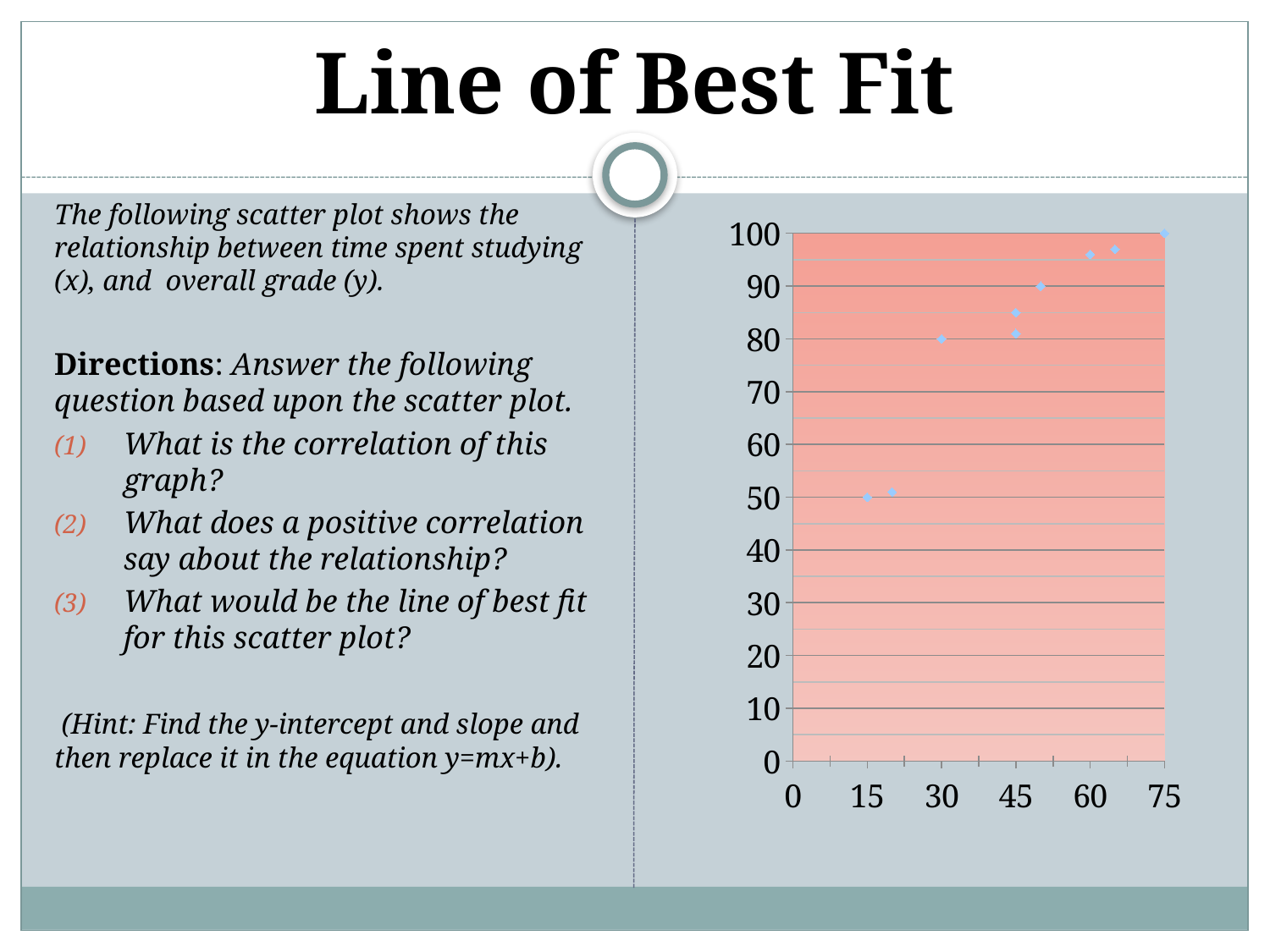
How many data points are plotted on the scatter plot? 9 Do the y values generally rise or fall as x increases along the x axis? rise What is the y value of the point plotted at x = 15? 50 What is the largest tick value shown on the x axis? 75 Is the y value of the point at x = 20 greater or less than 60? less What is the highest value shown on the y axis? 100 At which x value is the highest point on the scatter plot? 75 What kind of chart is shown on the slide? scatter plot What is the y value of the point plotted at x = 30? 80 Is the y value of the point at x = 60 greater or less than 90? greater Which has the larger y value: the point at x = 30 or the point at x = 15? the point at x = 30 What is the y value of the point plotted at x = 75? 100